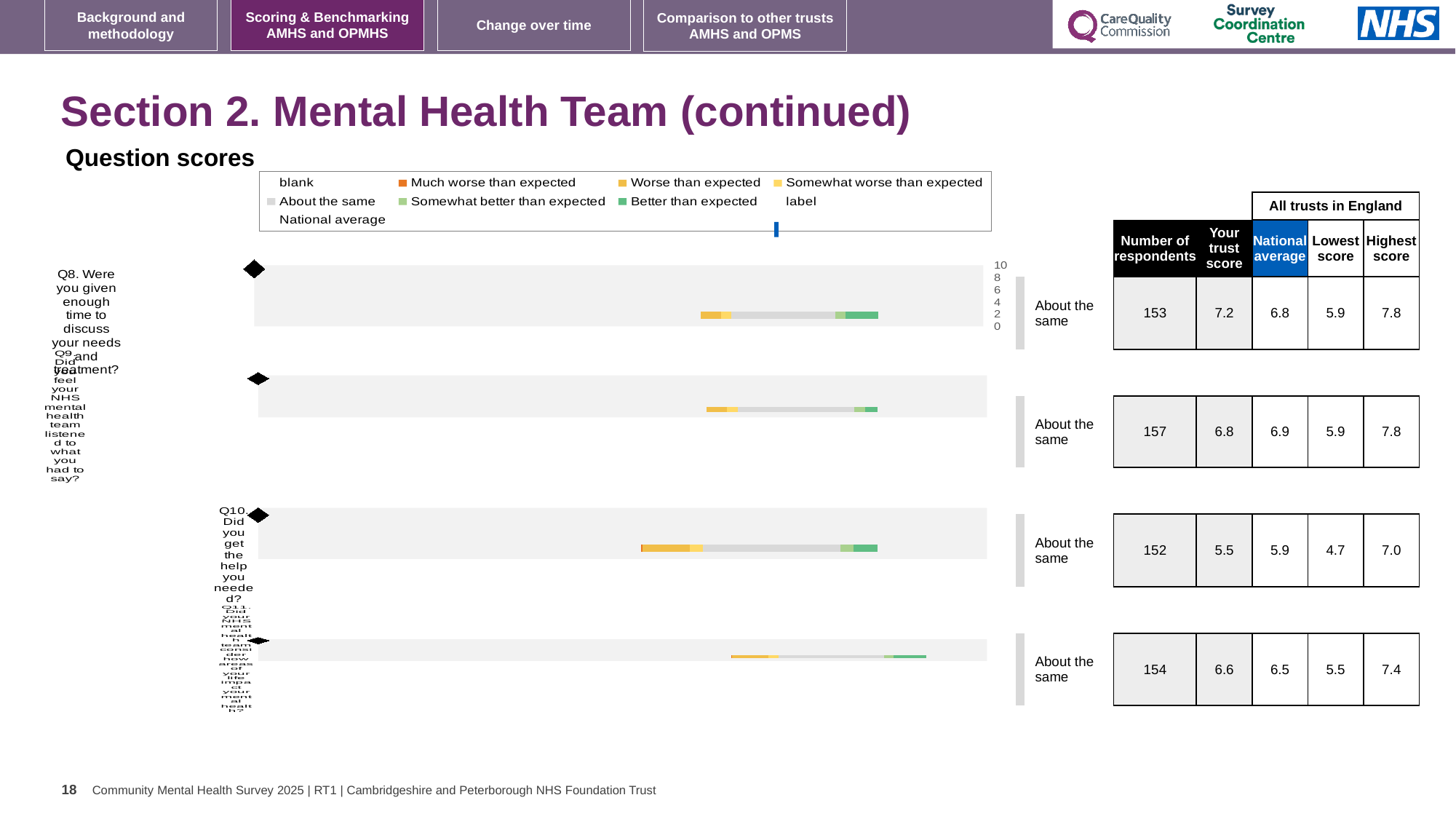
What is the highest score among all trusts in England for Q11? 7.4 What is the number of respondents for Q8? 153 What kind of chart is used to show the Q8 question score distribution? bar chart Which question has the highest 'Your trust score'? Q8 What is 'Your trust score' for Q10? 5.5 In the legend, what colour represents 'Better than expected'? green How many question charts (Q8 to Q11) are shown on the slide? 4 For Q10, what is the difference between the highest score and the lowest score among all trusts in England? 2.3 What is the national average for Q9? 6.9 For Q8, which is larger: 'Your trust score' or the national average? Your trust score In the legend, what colour represents 'Much worse than expected'? orange Which question has the lowest 'Your trust score'? Q10